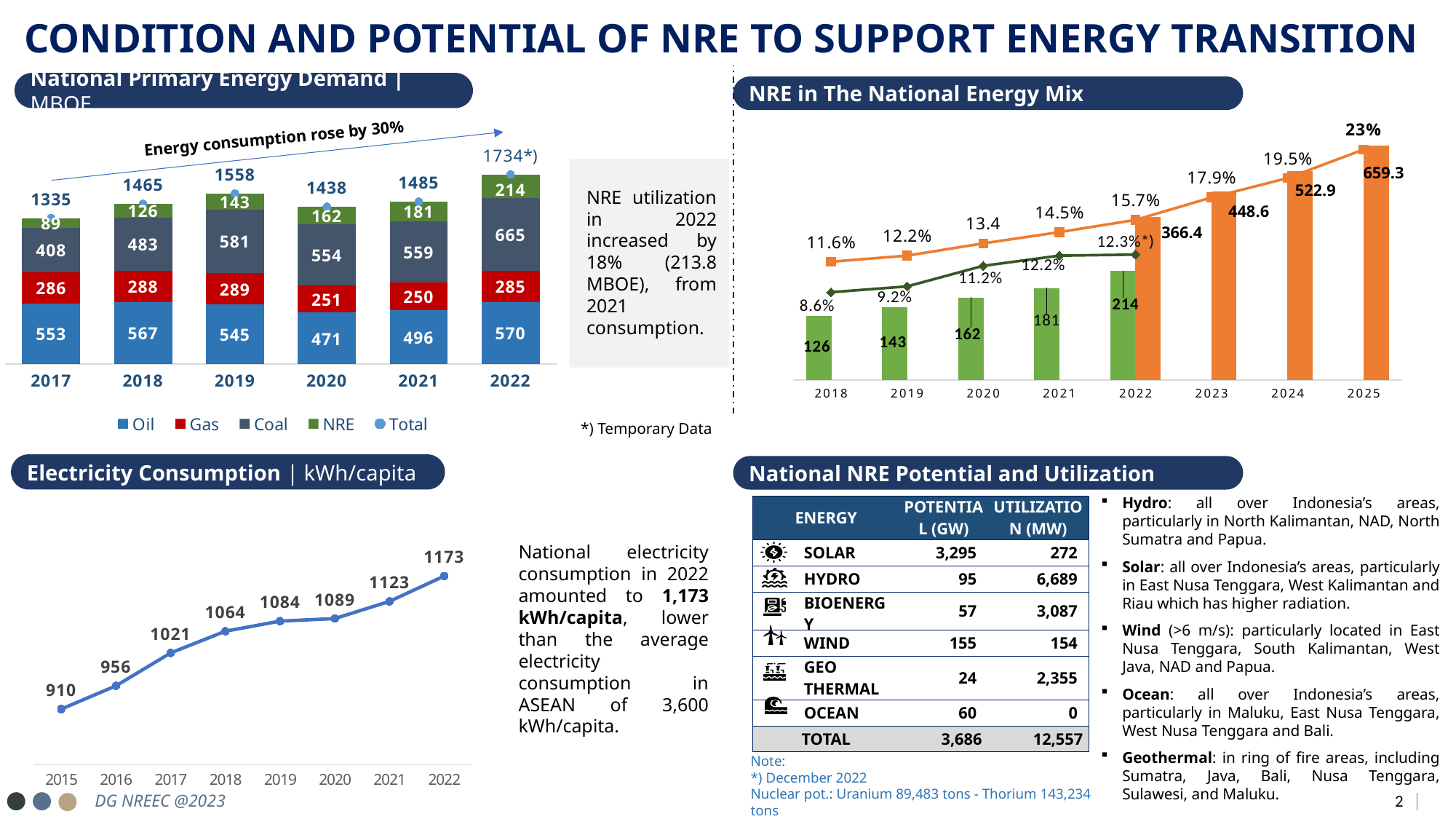
In the NRE in The National Energy Mix chart, what is the percentage shown on the orange line for 2025? 23% In the National Primary Energy Demand chart, what is the difference between the Coal values for 2019 and 2018? 98 In the NRE in The National Energy Mix chart, what is the value of the green bar for 2020? 162 In the Electricity Consumption chart, what is the value for 2019? 1084 In the National Primary Energy Demand chart, which year has the highest Total? 2022 How many years are shown on the x axis of the NRE in The National Energy Mix chart? 8 In the NRE in The National Energy Mix chart, which is larger: the orange bar for 2023 or the orange bar for 2022? 2023 How many series does the legend of the National Primary Energy Demand chart list? 5 In the National Primary Energy Demand chart, which year has the lowest Oil value? 2020 In the Electricity Consumption chart, what is the difference between the 2022 and 2015 values? 263 What kind of chart is the Electricity Consumption chart? line chart In the National Primary Energy Demand chart, what is the Oil value for 2022? 570